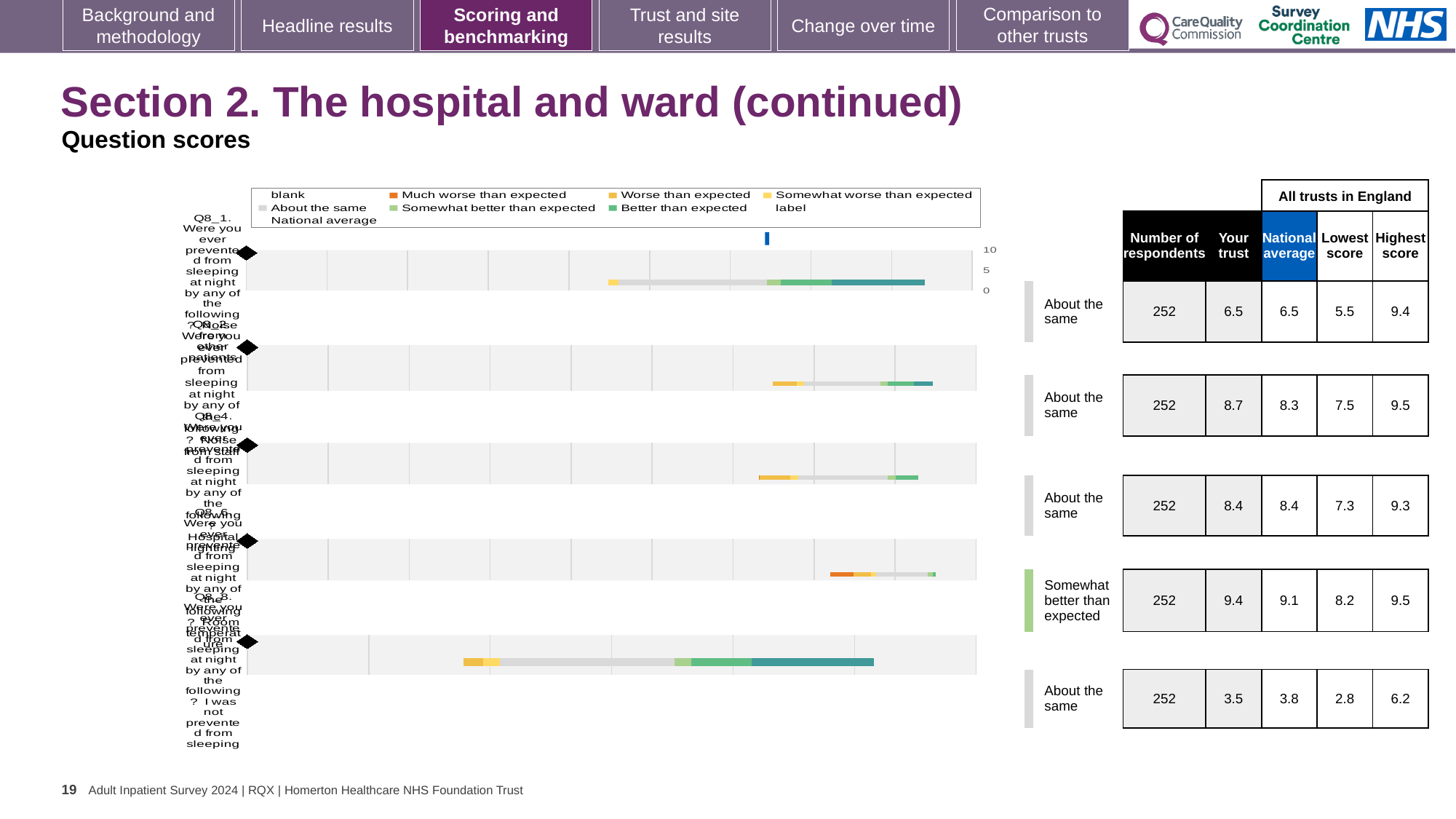
For the second row, which is larger: the 'Your trust' score or the 'National average'? Your trust (8.7) For the fifth row, what is the difference between the 'Highest score' and the 'Lowest score'? 3.4 What is the 'Highest score' for the fifth row from the top? 6.2 Which row is rated 'Somewhat better than expected' rather than 'About the same'? the fourth row Which row has the highest 'Your trust' score? the fourth row (9.4) What kind of chart is shown on the slide? bar chart What is the 'National average' score for the fourth row from the top? 9.1 Which row has the lowest 'Your trust' score? the fifth row (3.5) How many respondents are listed for each question row? 252 For the fourth row, what is the difference between the 'Your trust' score and the 'National average'? 0.3 What is the 'Your trust' score for the first row (Q8_1) in the table beside the chart? 6.5 How many question rows (bars) are plotted in the chart? 5